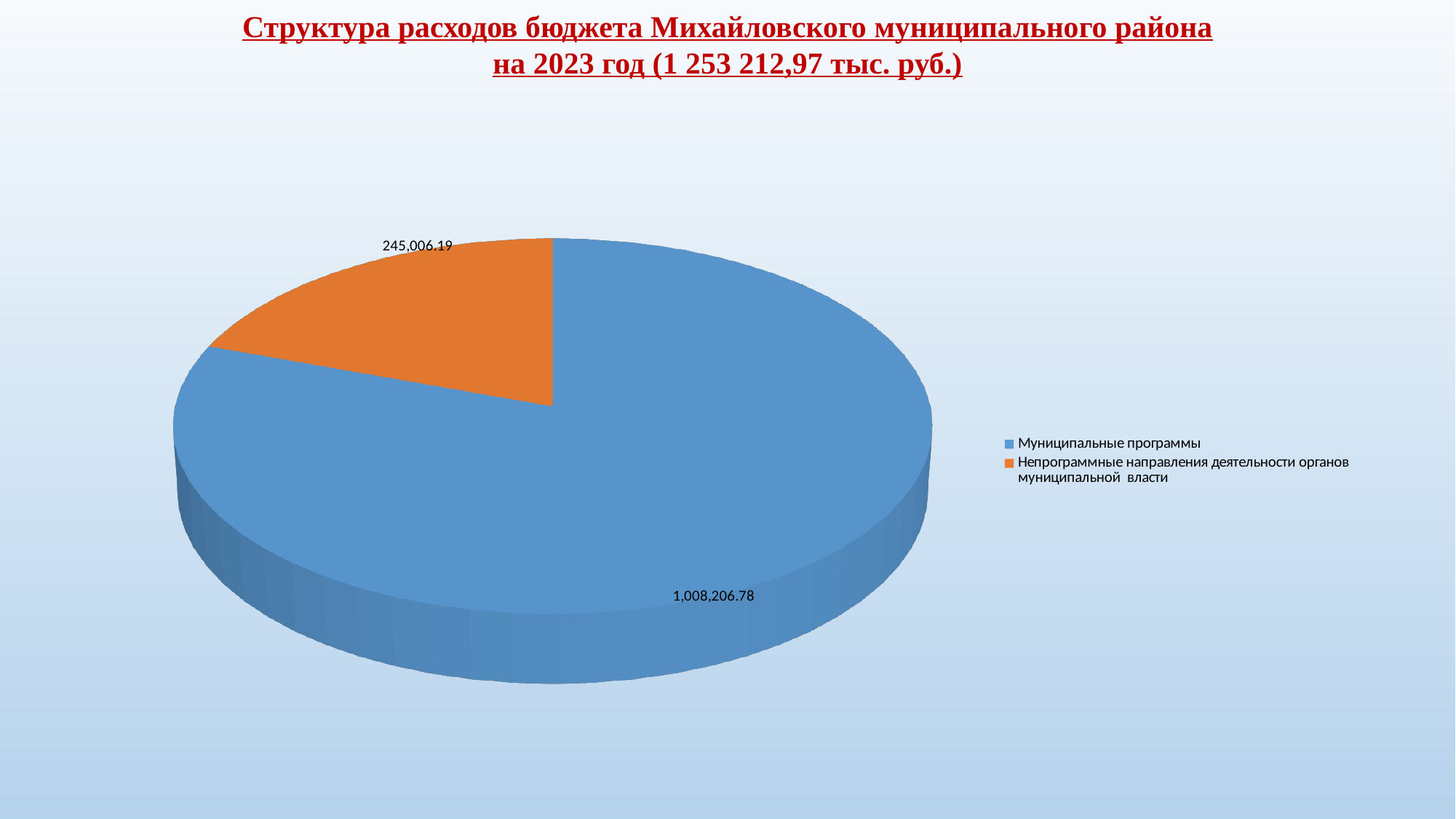
What type of chart is shown on the slide? Pie chart Which is larger: Муниципальные программы or Непрограммные направления деятельности органов муниципальной власти? Муниципальные программы Which category has the largest slice of the pie? Муниципальные программы How many entries does the legend list? 2 Which category has the smallest slice of the pie? Непрограммные направления деятельности органов муниципальной власти What is the title of the chart on the slide? Структура расходов бюджета Михайловского муниципального района на 2023 год (1 253 212,97 тыс. руб.) What is the value for Непрограммные направления деятельности органов муниципальной власти? 245,006.19 How many slices does the pie chart have? 2 What colour is the slice for Непрограммные направления деятельности органов муниципальной власти? Orange What is the value for Муниципальные программы? 1,008,206.78 What is the total of the two slices in the pie chart? 1,253,212.97 What is the difference between the value for Муниципальные программы and the value for Непрограммные направления деятельности органов муниципальной власти? 763,200.59